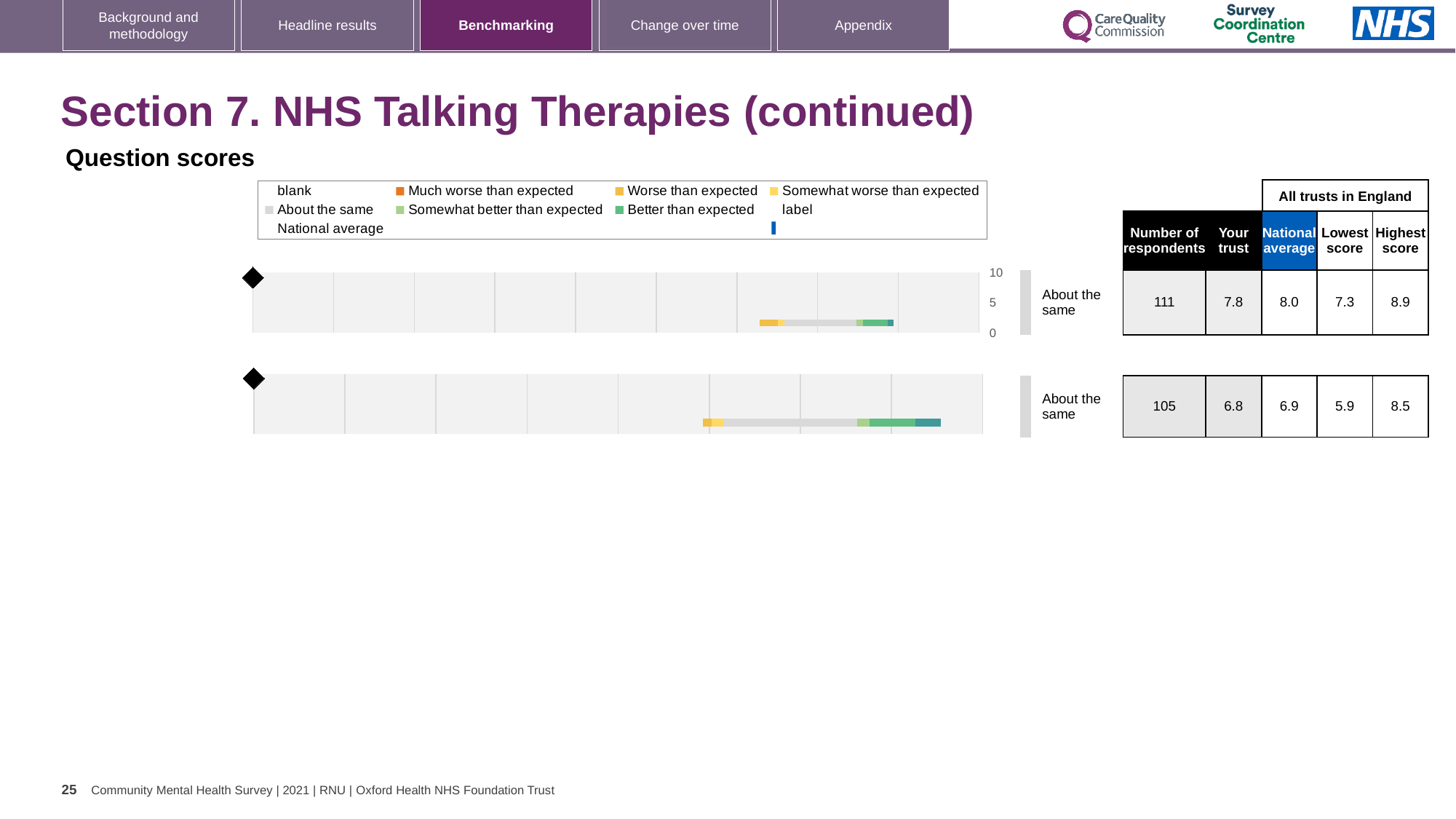
What kind of chart is used on this slide to show the question scores? bar chart For the top chart row, what is the 'Your trust' score? 7.8 For the top chart row, how many respondents are there? 111 For the top chart row, what is the national average score? 8.0 For the top chart row, which is larger: the 'Your trust' score or the national average? National average For the bottom chart row, what is the difference between the highest score and the lowest score? 2.6 For the top chart row, what is the difference between the highest score and the lowest score? 1.6 For the bottom chart row, what is the lowest score among all trusts in England? 5.9 What benchmark category label is shown next to both chart rows? About the same For the bottom chart row, what is the 'Your trust' score? 6.8 What is the maximum value shown on the vertical axis of the top chart? 10 How many more respondents does the top chart row have than the bottom chart row? 6